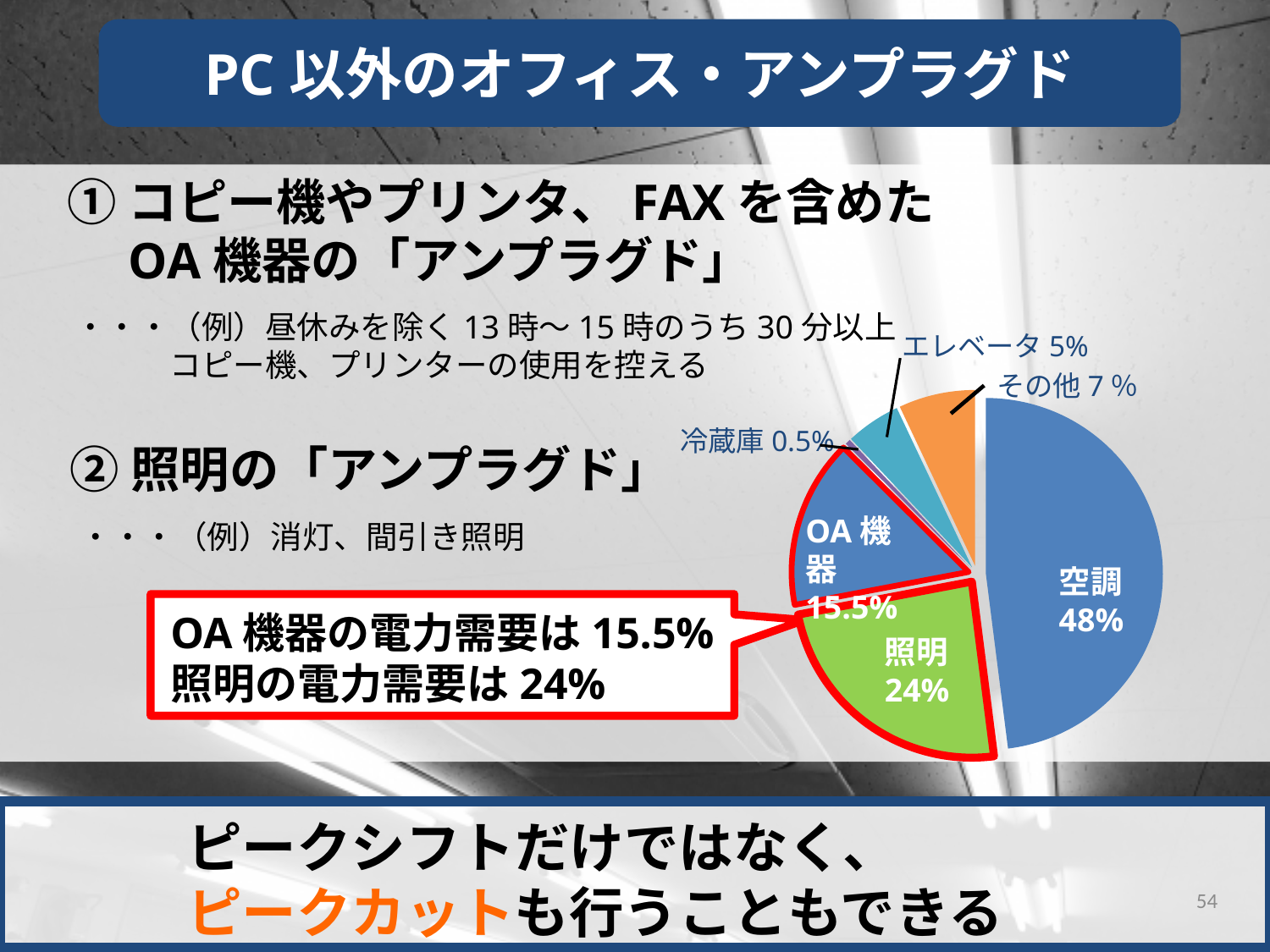
What is the value shown for エレベータ? 5% How many slices does the pie chart have? 6 What is the difference between the values for 照明 and OA機器? 8.5% Which is larger, the value for その他 or the value for エレベータ? その他 What is the value shown for 照明? 24% What share of the pie does 空調 account for? 48% Which category has the smallest slice of the pie? 冷蔵庫 What kind of chart is shown on the slide? pie chart What is the value shown for OA機器? 15.5% Which category has the largest slice of the pie? 空調 What is the value shown for 冷蔵庫? 0.5% What is the value shown for その他? 7%